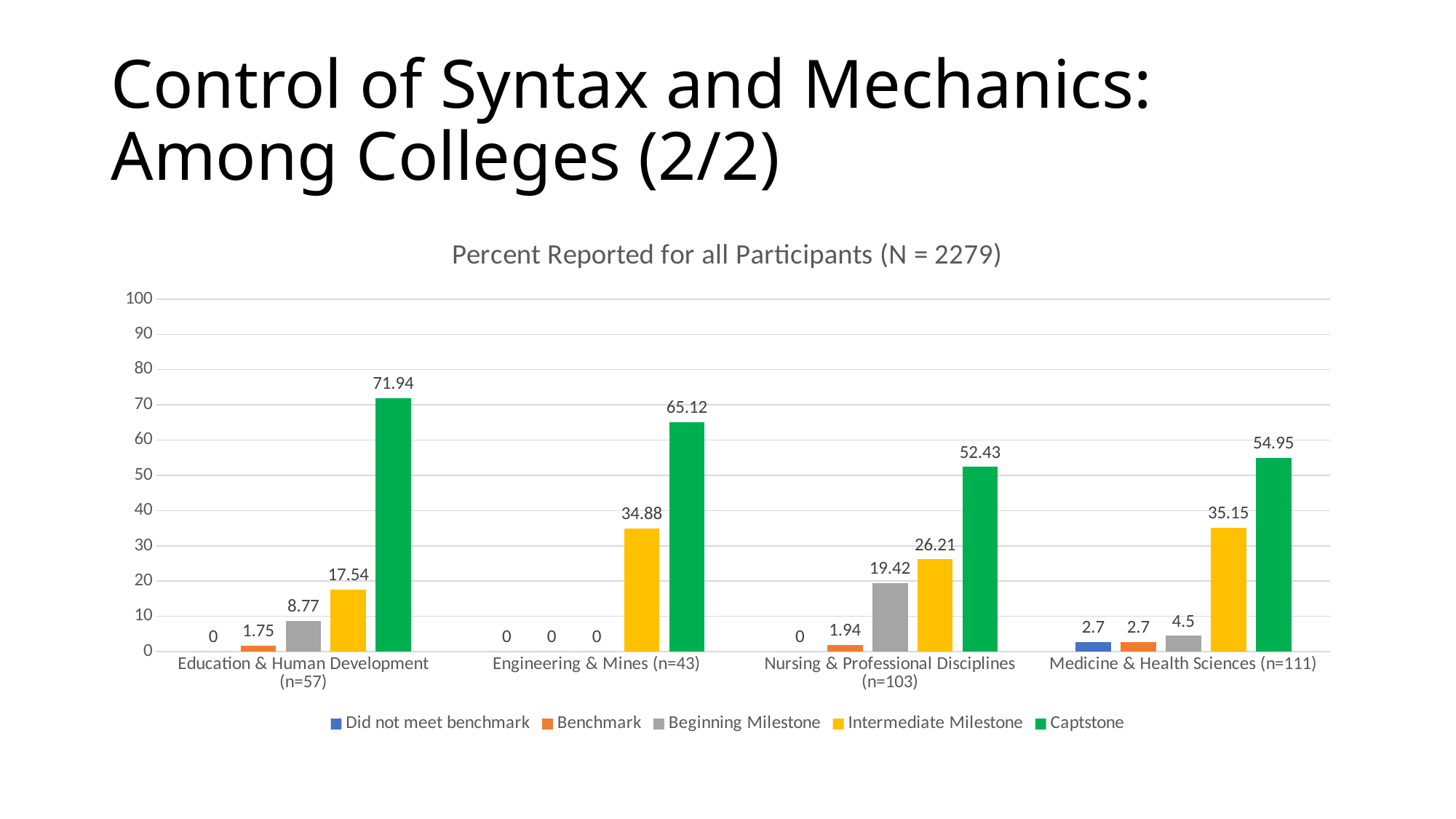
What is the difference between the Captstone values for Engineering & Mines (n=43) and Medicine & Health Sciences (n=111)? 10.17 Which is larger, the Intermediate Milestone value for Nursing & Professional Disciplines (n=103) or for Medicine & Health Sciences (n=111)? Medicine & Health Sciences (n=111) What is the Beginning Milestone value for Nursing & Professional Disciplines (n=103)? 19.42 What is the Intermediate Milestone value for Engineering & Mines (n=43)? 34.88 Which college has the lowest Captstone value? Nursing & Professional Disciplines (n=103) Which college has the highest Captstone value? Education & Human Development (n=57) What is the Captstone value for Education & Human Development (n=57)? 71.94 How many colleges are shown on the x axis? 4 What kind of chart is shown on the slide? Bar chart How many series does the legend list? 5 What is the title of the chart? Percent Reported for all Participants (N = 2279) What is the Did not meet benchmark value for Medicine & Health Sciences (n=111)? 2.7